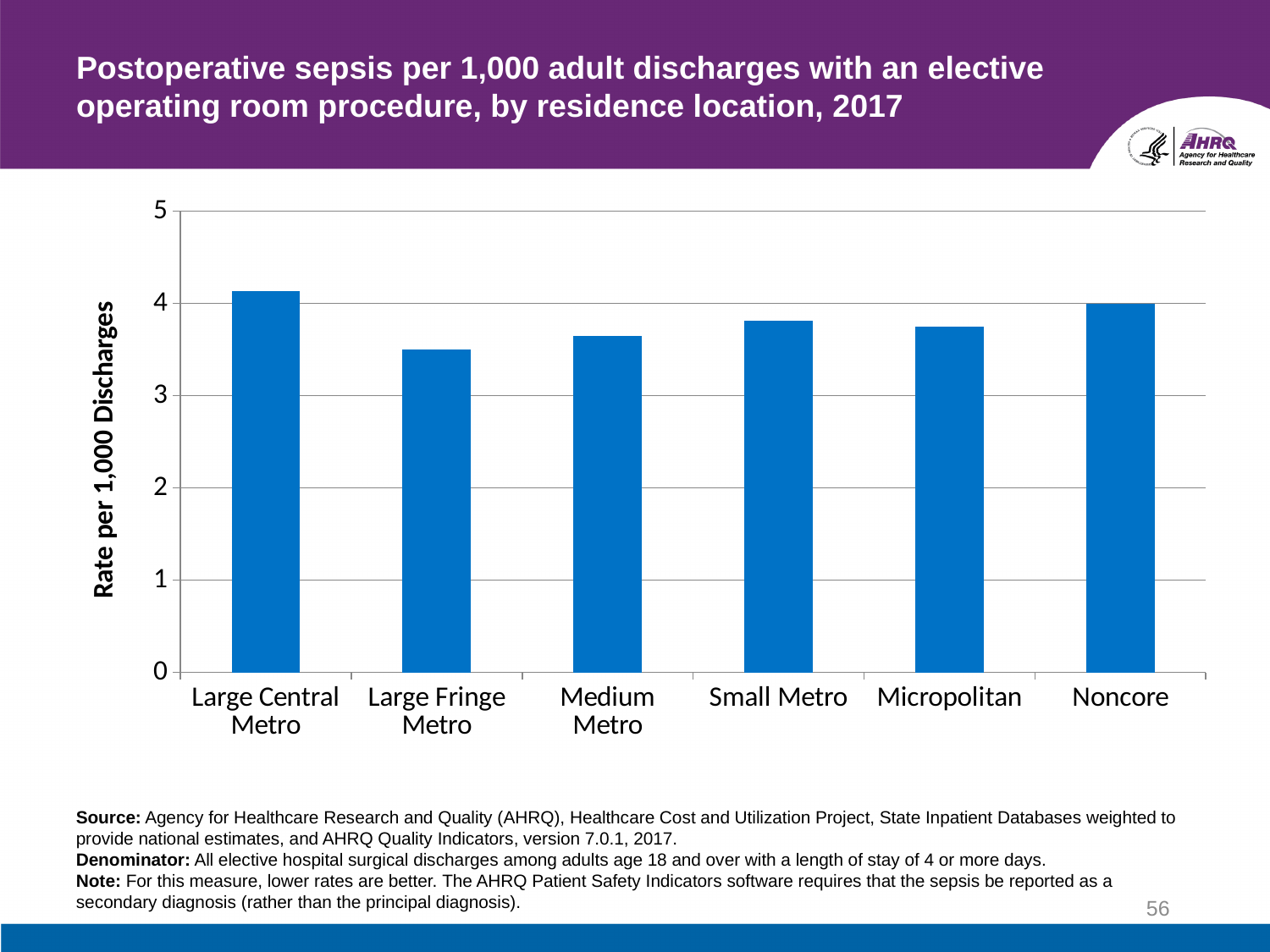
Is the value for Large Fringe Metro greater or less than 4? less Which is larger, the rate for Small Metro or the rate for Medium Metro? Small Metro Is the value for Medium Metro greater or less than 3? greater How many residence location categories are shown on the x axis? 6 Which is larger, the rate for Large Central Metro or the rate for Large Fringe Metro? Large Central Metro Is the value for Large Central Metro greater or less than 4? greater Which residence location has the lowest postoperative sepsis rate? Large Fringe Metro What kind of chart is shown on the slide? Bar chart What year does the chart title say the data are from? 2017 Which residence location has the highest postoperative sepsis rate? Large Central Metro What is the label of the y axis? Rate per 1,000 Discharges